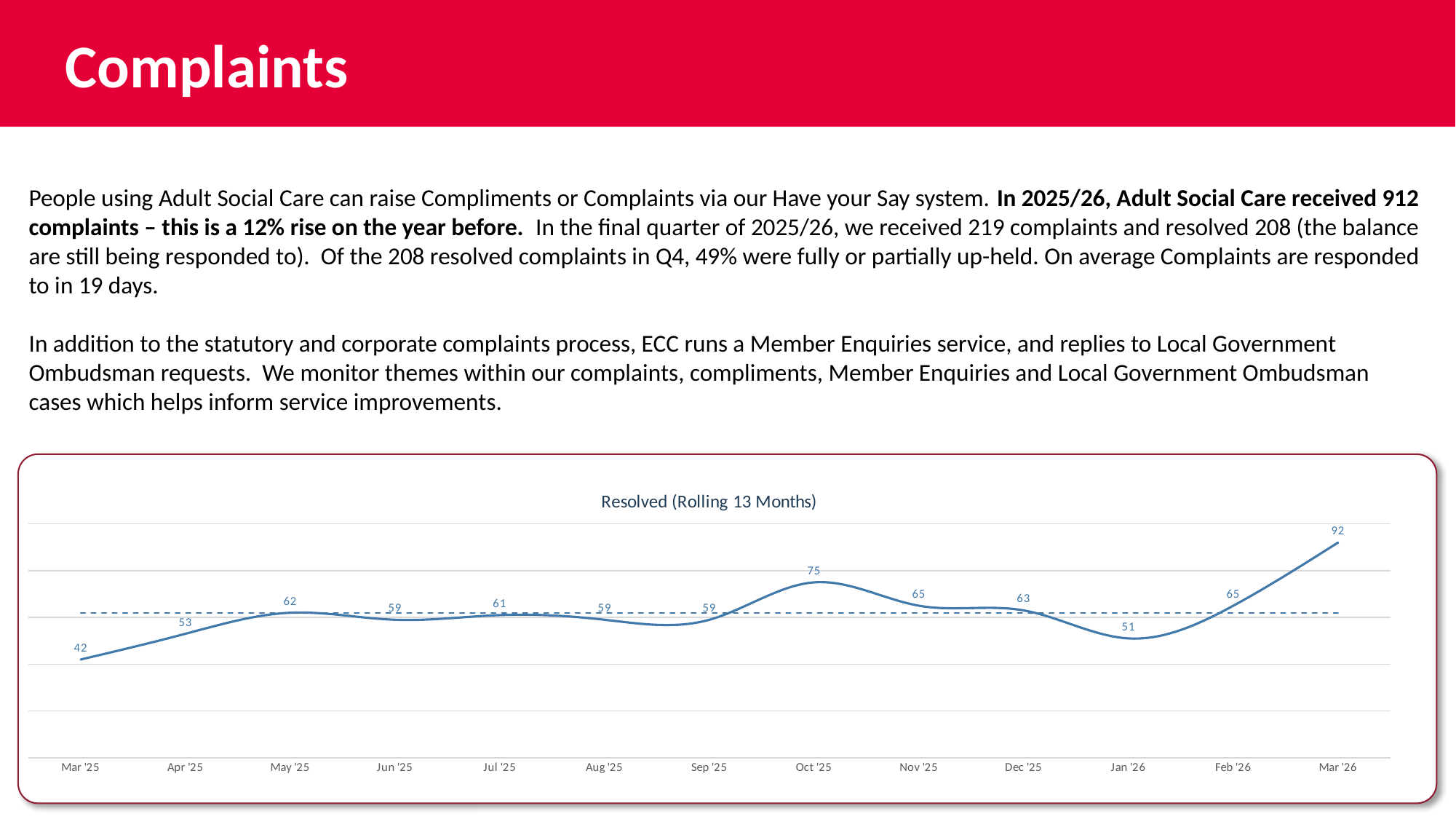
Which month has the lowest value? Mar '25 Do the values rise or fall from Dec '25 to Jan '26? fall Which is larger, the value for Oct '25 or the value for Nov '25? Oct '25 What is the value for Mar '25? 42 How many months are plotted on the x axis? 13 What is the difference between the values for Oct '25 and Mar '25? 33 What kind of chart is shown on the slide? line chart What is the title of the chart? Resolved (Rolling 13 Months) What is the difference between the values for Mar '26 and Feb '26? 27 What is the value for Jan '26? 51 What is the value for Oct '25? 75 Which month has the highest value? Mar '26